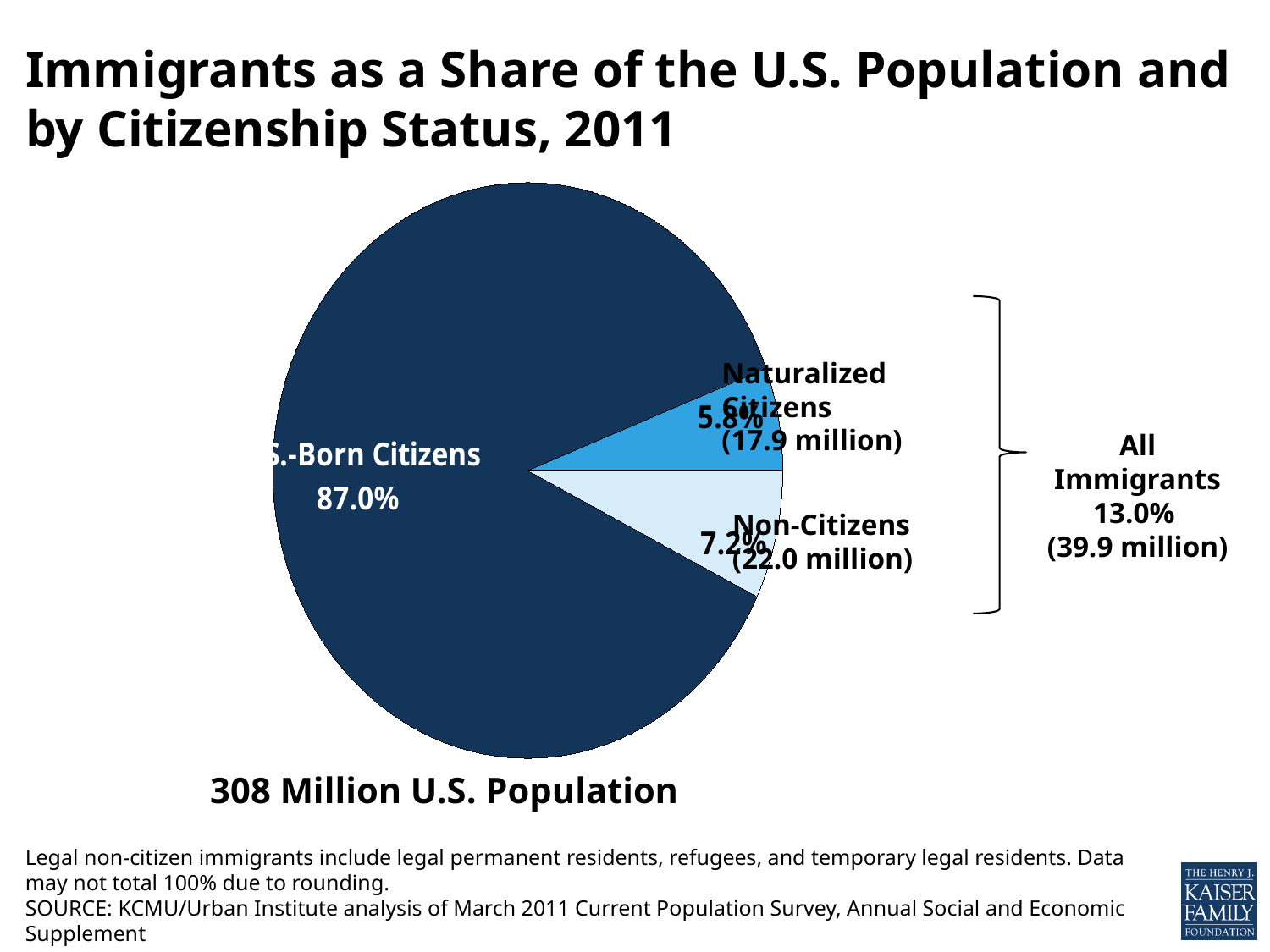
How many slices does the pie chart have? 3 How many Naturalized Citizens are there, in millions, according to the chart? 17.9 million Which slice of the pie is the smallest? Naturalized Citizens Which is larger, the Non-Citizens share or the Naturalized Citizens share? Non-Citizens What share of the U.S. population is Naturalized Citizens? 5.8% What share of the U.S. population is U.S.-Born Citizens? 87.0% What kind of chart is shown on the slide? Pie chart Which slice of the pie is the largest? U.S.-Born Citizens What share of the U.S. population is All Immigrants? 13.0% How many Non-Citizens are there, in millions, according to the chart? 22.0 million What share of the U.S. population is Non-Citizens? 7.2% What is the difference in percentage points between the Non-Citizens share and the Naturalized Citizens share? 1.4 percentage points